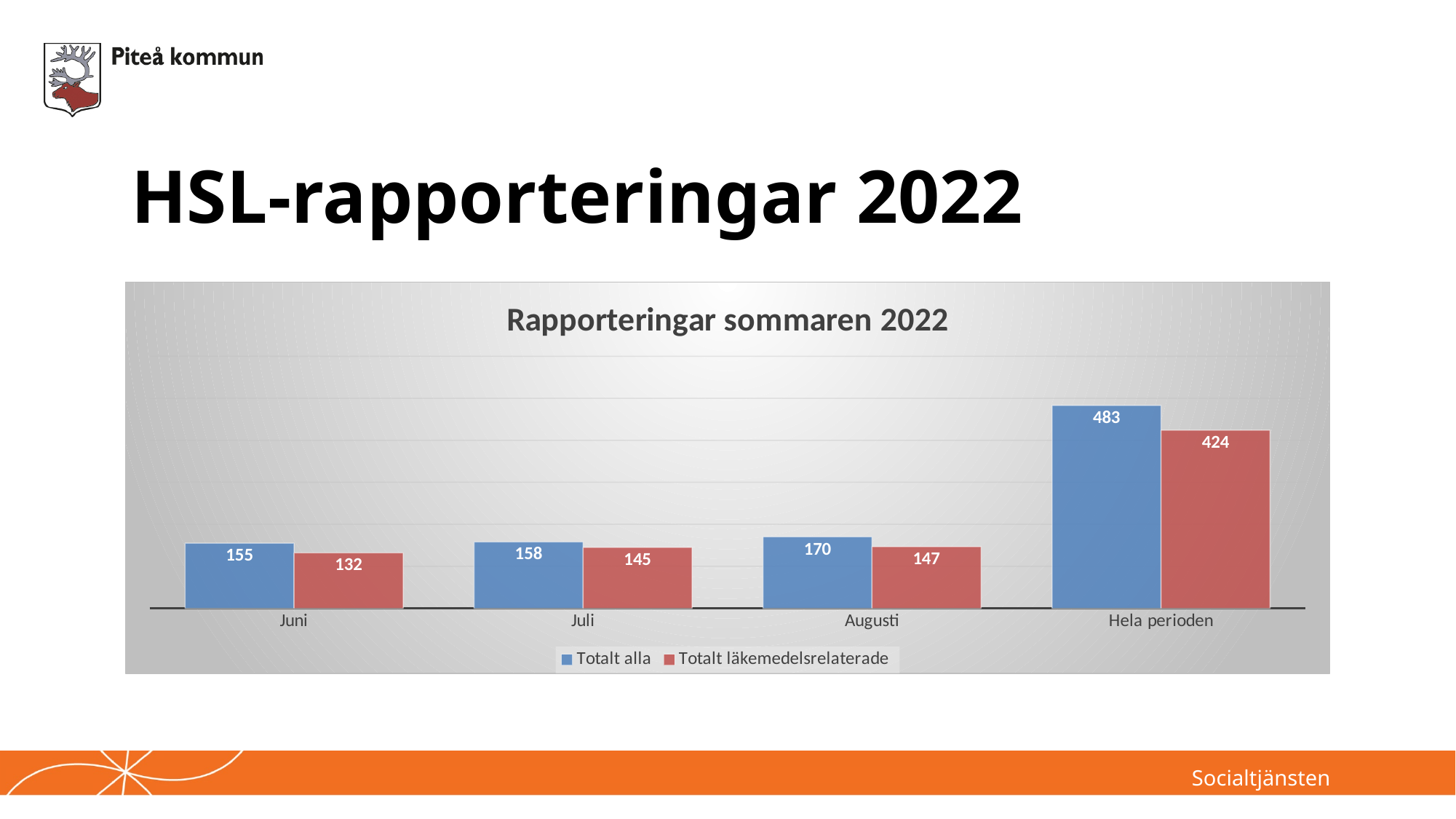
What is the value of Totalt alla for Hela perioden? 483 How many series does the legend list? 2 Which category has the highest value for Totalt alla? Hela perioden What is the value of Totalt läkemedelsrelaterade for Juli? 145 Which is larger: Totalt läkemedelsrelaterade for Juli or Totalt alla for Juni? Totalt alla for Juni What is the value of Totalt alla for Juni? 155 What is the difference between Totalt alla for Augusti and Totalt alla for Juni? 15 What is the value of Totalt läkemedelsrelaterade for Augusti? 147 What is the difference between Totalt alla and Totalt läkemedelsrelaterade for Hela perioden? 59 How many categories are shown on the x axis? 4 Which category has the lowest value for Totalt läkemedelsrelaterade? Juni What is the title of the chart? Rapporteringar sommaren 2022